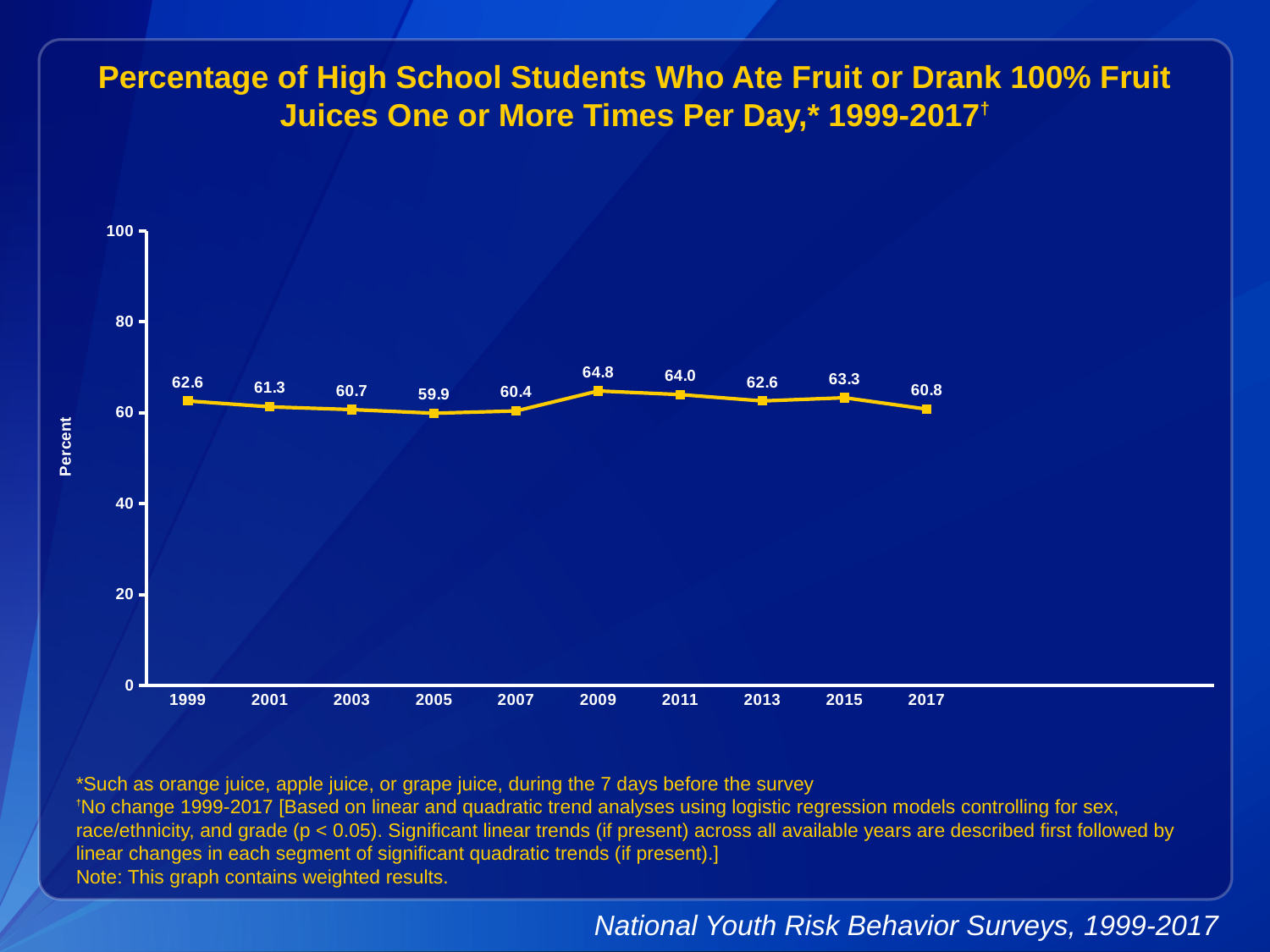
What kind of chart is shown on the slide? Line chart What value is shown for 2009? 64.8 What was the percentage of high school students who ate fruit or drank 100% fruit juices one or more times per day in 1999? 62.6 Which year has the highest value on the chart? 2009 How many years are plotted on the chart? 10 Did the value rise or fall from 2015 to 2017? fall Which year has the lowest value on the chart? 2005 What is the difference between the values for 2009 and 2005? 4.9 What value is shown for 2017? 60.8 Is the value for 2015 greater or less than 80? less What is the label on the y axis of the chart? Percent Which year has a larger value, 2011 or 2013? 2011